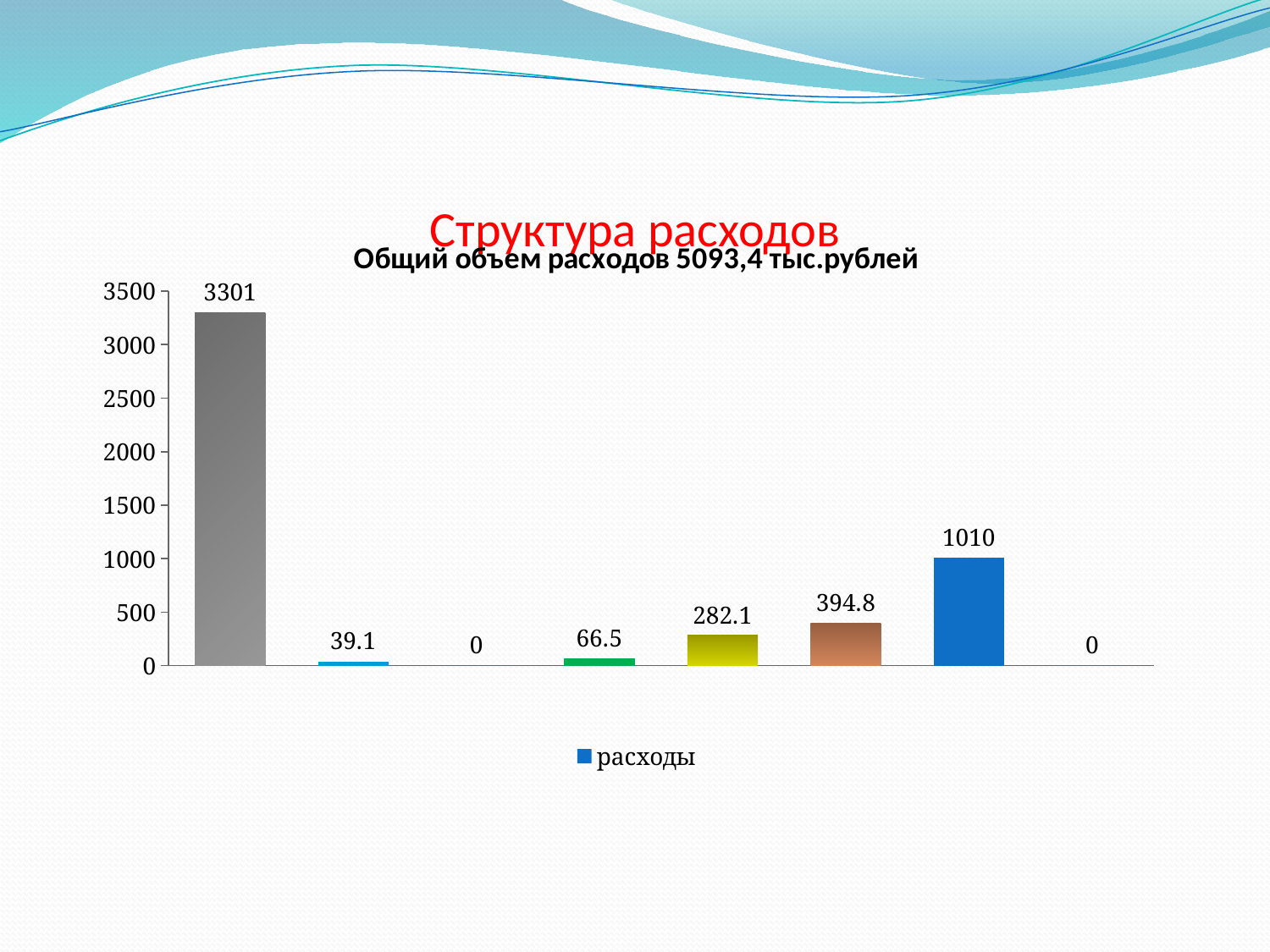
Which is larger, the brown bar or the yellow bar? the brown bar (394.8) What is the value shown on the dark blue bar, the seventh from the left? 1010 What is the value shown on the light blue bar, the second from the left? 39.1 What is the value shown on the yellow bar, the fifth from the left? 282.1 What type of chart is shown on the slide? bar chart How many bars (data points) are plotted in the chart, including those with a value of 0? 8 What is the highest value shown in the chart? 3301 What is the value shown on the green bar, the fourth from the left? 66.5 What is the value shown on the tallest (gray) bar? 3301 How many series does the legend list, and what is it called? 1, расходы What is the value shown on the brown bar, the sixth from the left? 394.8 What is the difference between the gray bar (3301) and the dark blue bar (1010)? 2291